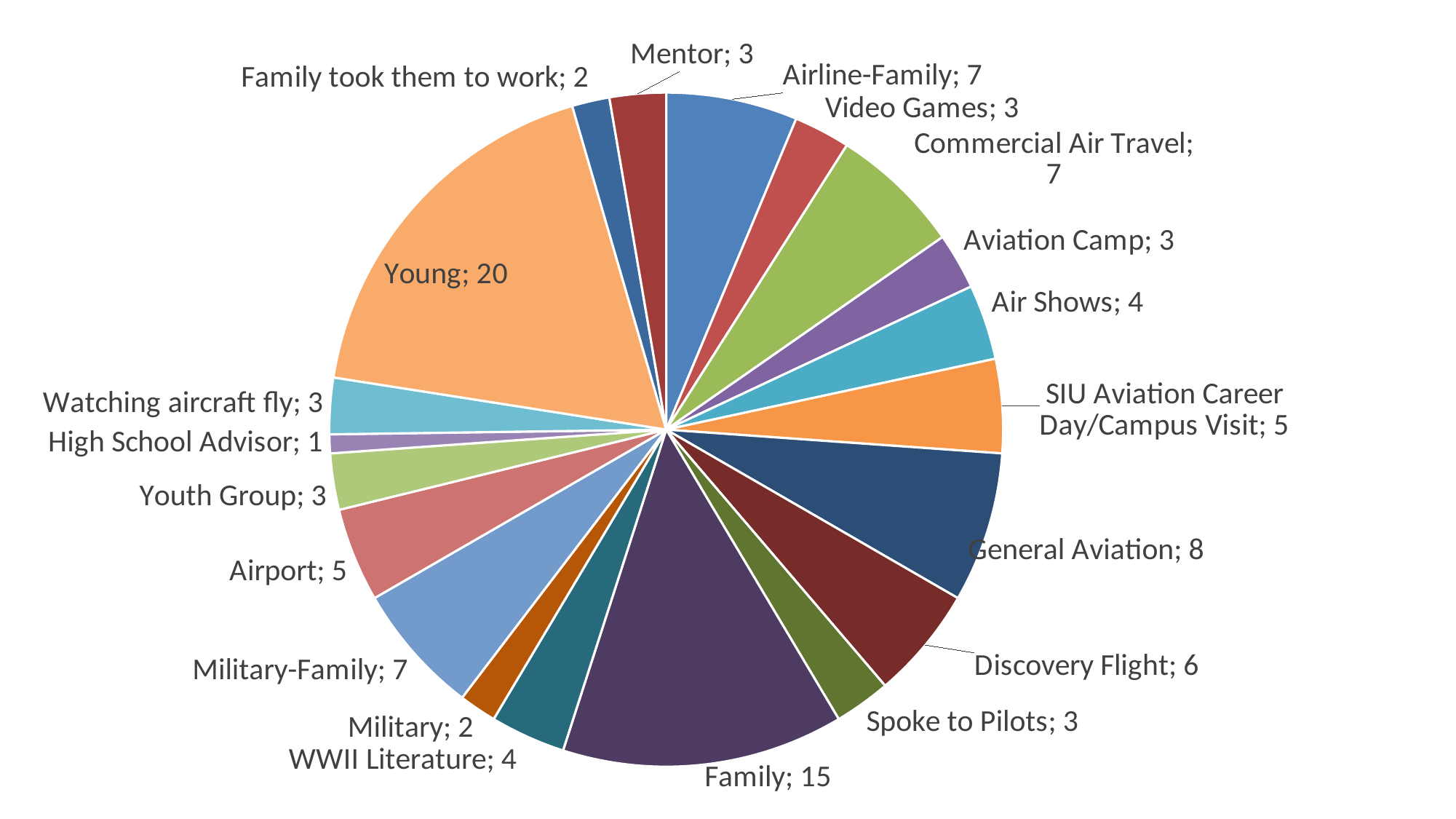
What is the total of all the slice values in the pie chart? 111 What is the value for SIU Aviation Career Day/Campus Visit? 5 What is the value for the Young slice? 20 How many categories are shown in the pie chart? 20 Which category has the largest slice? Young Which is larger, Air Shows or Aviation Camp? Air Shows Which category has the smallest slice? High School Advisor What is the difference between the values for General Aviation and Discovery Flight? 2 What is the value for General Aviation? 8 Which is larger, Military-Family or Airport? Military-Family What is the difference between the values for Young and Family? 5 What kind of chart is shown on the slide? Pie chart